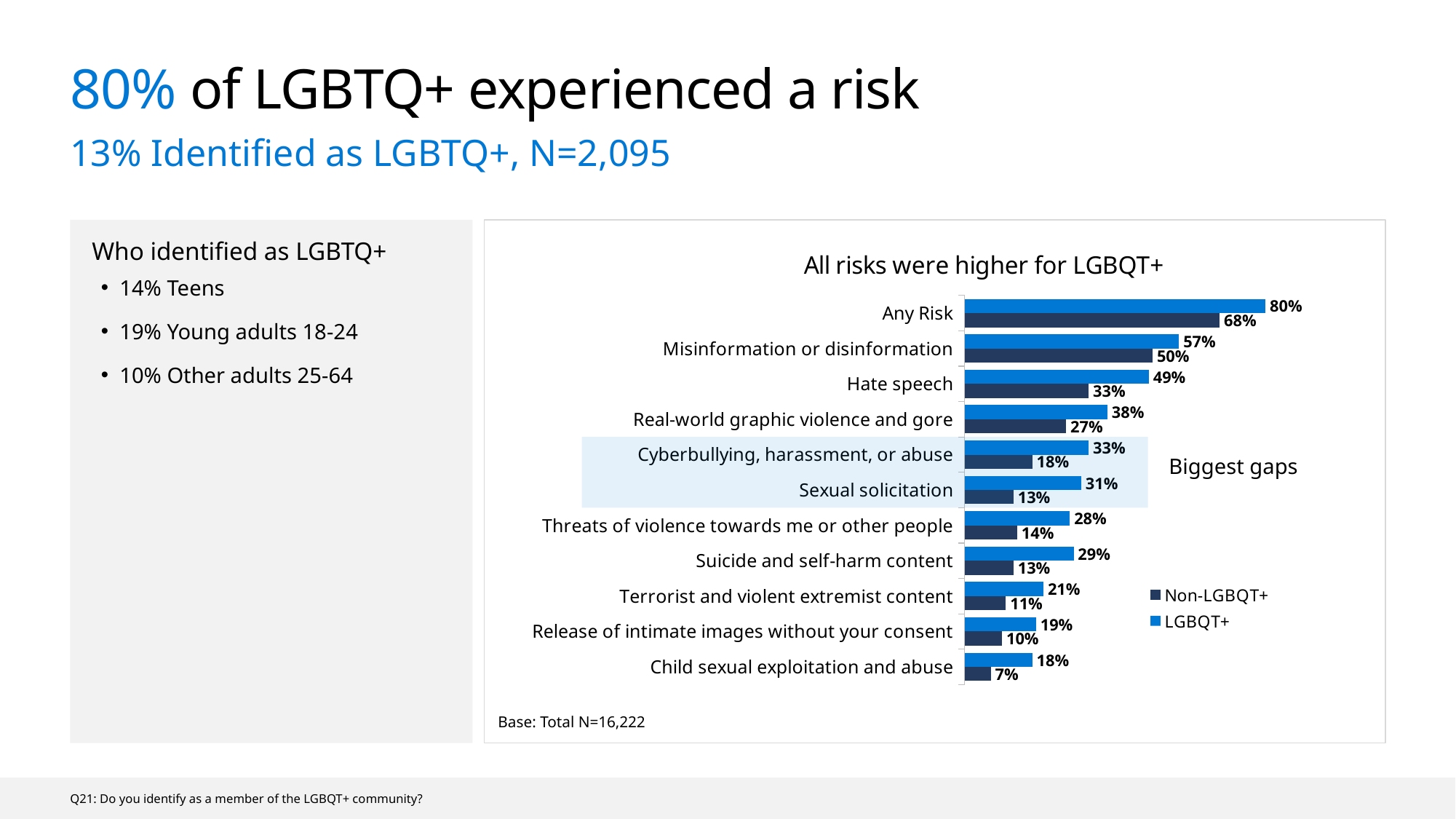
What kind of chart is shown on the slide? Bar chart What is the difference between the LGBQT+ and Non-LGBQT+ values for Any Risk? 12% How many series does the legend list? 2 Which category has the lowest Non-LGBQT+ value? Child sexual exploitation and abuse What is the LGBQT+ value for Child sexual exploitation and abuse? 18% How many categories are shown on the chart? 11 What is the difference between the LGBQT+ and Non-LGBQT+ values for Cyberbullying, harassment, or abuse? 15% What is the LGBQT+ value for Hate speech? 49% Which is larger: the LGBQT+ value for Suicide and self-harm content or the LGBQT+ value for Threats of violence towards me or other people? Suicide and self-harm content What is the title of the chart? All risks were higher for LGBQT+ Which category has the highest LGBQT+ value? Any Risk What is the Non-LGBQT+ value for Sexual solicitation? 13%